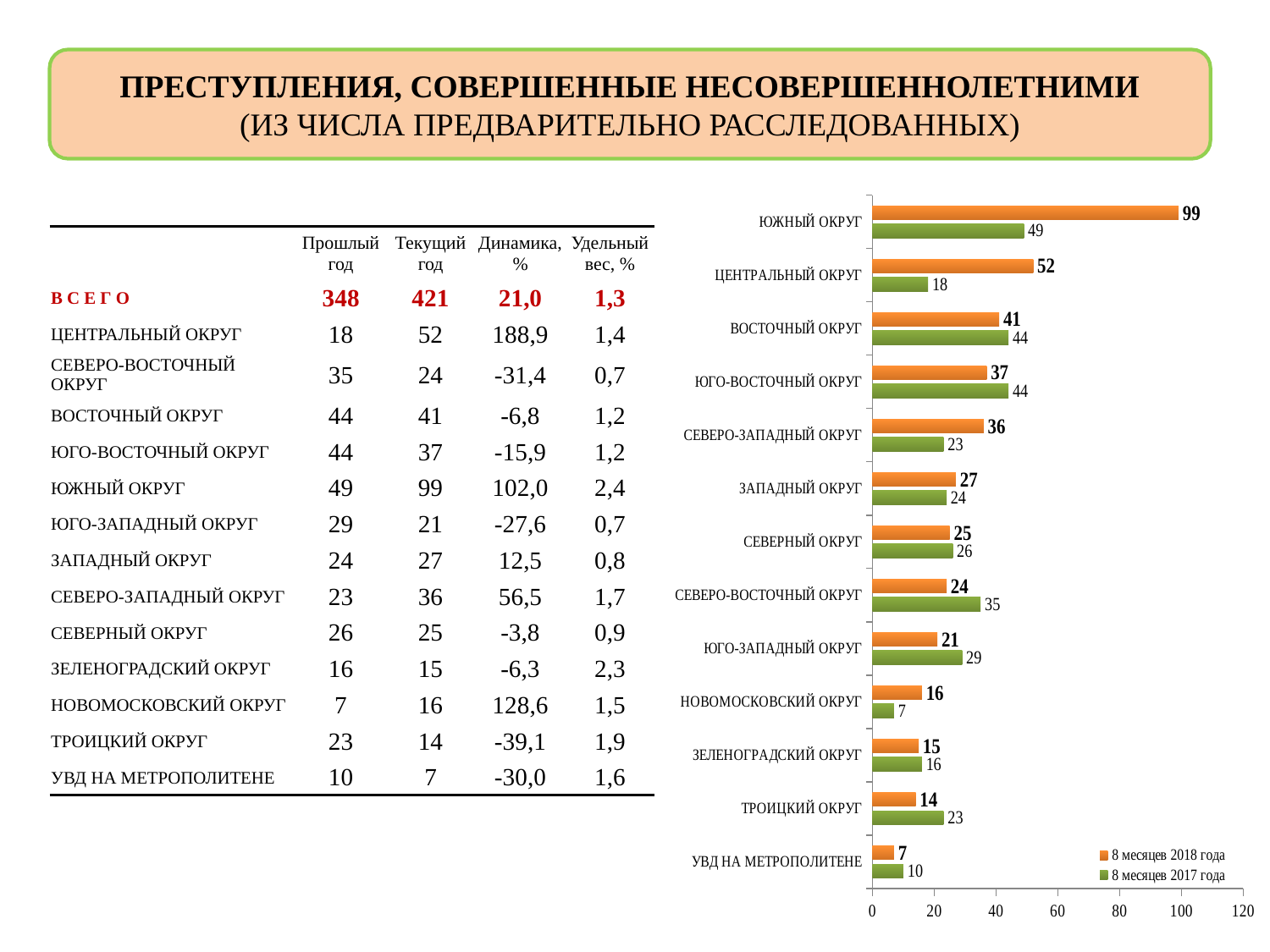
What is the value for ЦЕНТРАЛЬНЫЙ ОКРУГ in the series '8 месяцев 2017 года'? 18 Which category has the lowest value in the series '8 месяцев 2018 года'? УВД НА МЕТРОПОЛИТЕНЕ Which colour represents the series '8 месяцев 2017 года' in the chart? green Which category has the highest value in the series '8 месяцев 2018 года'? ЮЖНЫЙ ОКРУГ What is the value for СЕВЕРО-ВОСТОЧНЫЙ ОКРУГ in the series '8 месяцев 2017 года'? 35 What type of chart is shown on the slide? bar chart How many categories (districts) are shown on the chart? 13 What is the difference between the '8 месяцев 2018 года' and '8 месяцев 2017 года' values for ЮЖНЫЙ ОКРУГ? 50 What is the value for ЮЖНЫЙ ОКРУГ in the series '8 месяцев 2018 года'? 99 How many series does the chart legend list? 2 Is the value for ЦЕНТРАЛЬНЫЙ ОКРУГ in the series '8 месяцев 2018 года' greater or less than 40? greater For ВОСТОЧНЫЙ ОКРУГ, which series has the larger value: '8 месяцев 2018 года' or '8 месяцев 2017 года'? 8 месяцев 2017 года